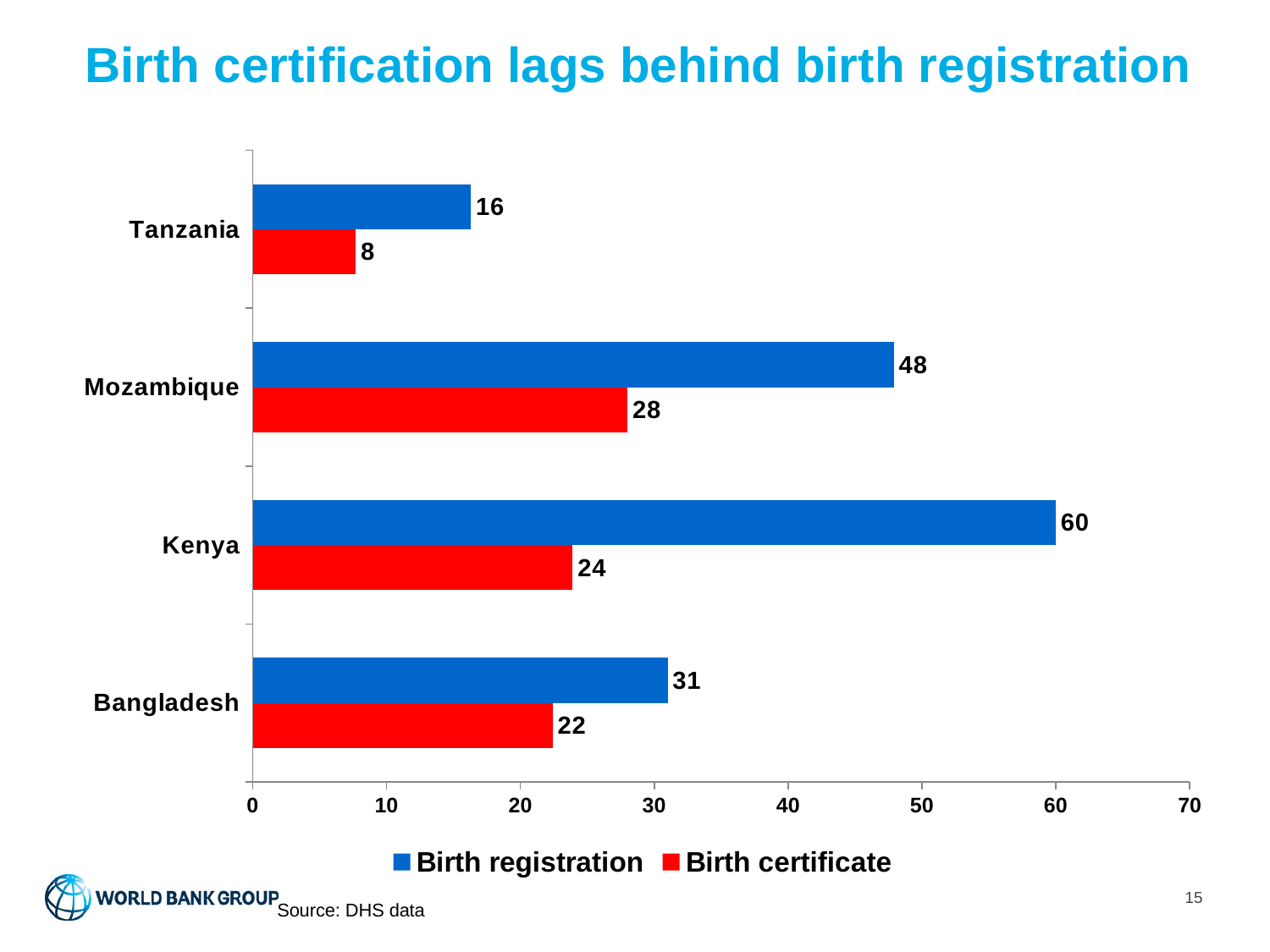
What is the Birth certificate value for Mozambique? 28 How many countries are shown on the chart? 4 How many series does the legend list? 2 Which country has the highest Birth registration value? Kenya What is the Birth certificate value for Tanzania? 8 What is the Birth registration value for Kenya? 60 Which country has the lowest Birth certificate value? Tanzania What colour represents Birth certificate in the chart? Red Is the Birth registration value for Mozambique greater or less than 40? greater What is the difference between Birth registration and Birth certificate for Kenya? 36 Which is larger: the Birth certificate value for Bangladesh or for Kenya? Kenya What kind of chart is shown on the slide? Bar chart